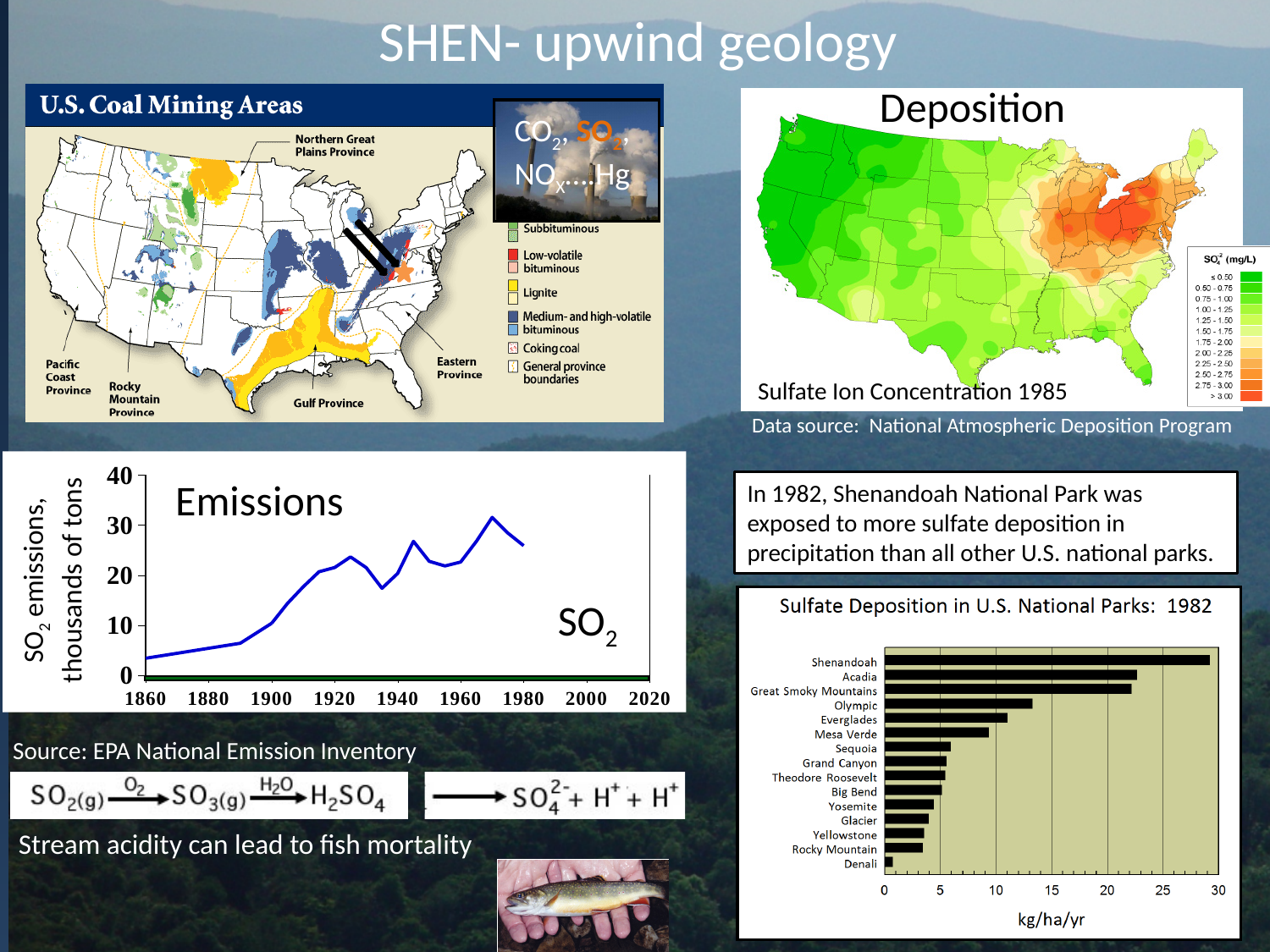
On the 'Emissions' chart, do SO2 emissions generally rise or fall between 1860 and 1920? rise On the 'Emissions' chart, is the SO2 emissions value in 1980 greater or less than 20 thousand tons? greater On the 'Sulfate Deposition in U.S. National Parks: 1982' chart, which park has the lowest sulfate deposition? Denali On the 'Sulfate Deposition in U.S. National Parks: 1982' chart, what unit is shown on the horizontal axis? kg/ha/yr On the 'Sulfate Deposition in U.S. National Parks: 1982' chart, which park has the highest sulfate deposition? Shenandoah What kind of chart is the 'Emissions' chart on the lower left of the slide? line chart On the 'Sulfate Deposition in U.S. National Parks: 1982' chart, which has the larger value, Olympic or Everglades? Olympic On the 'Sulfate Deposition in U.S. National Parks: 1982' chart, is the value for Denali greater or less than 5 kg/ha/yr? less On the 'Sulfate Deposition in U.S. National Parks: 1982' chart, how many national parks are listed? 15 What kind of chart is the 'Sulfate Deposition in U.S. National Parks: 1982' chart? bar chart On the 'Emissions' chart, is the SO2 emissions value in 1860 greater or less than 10 thousand tons? less